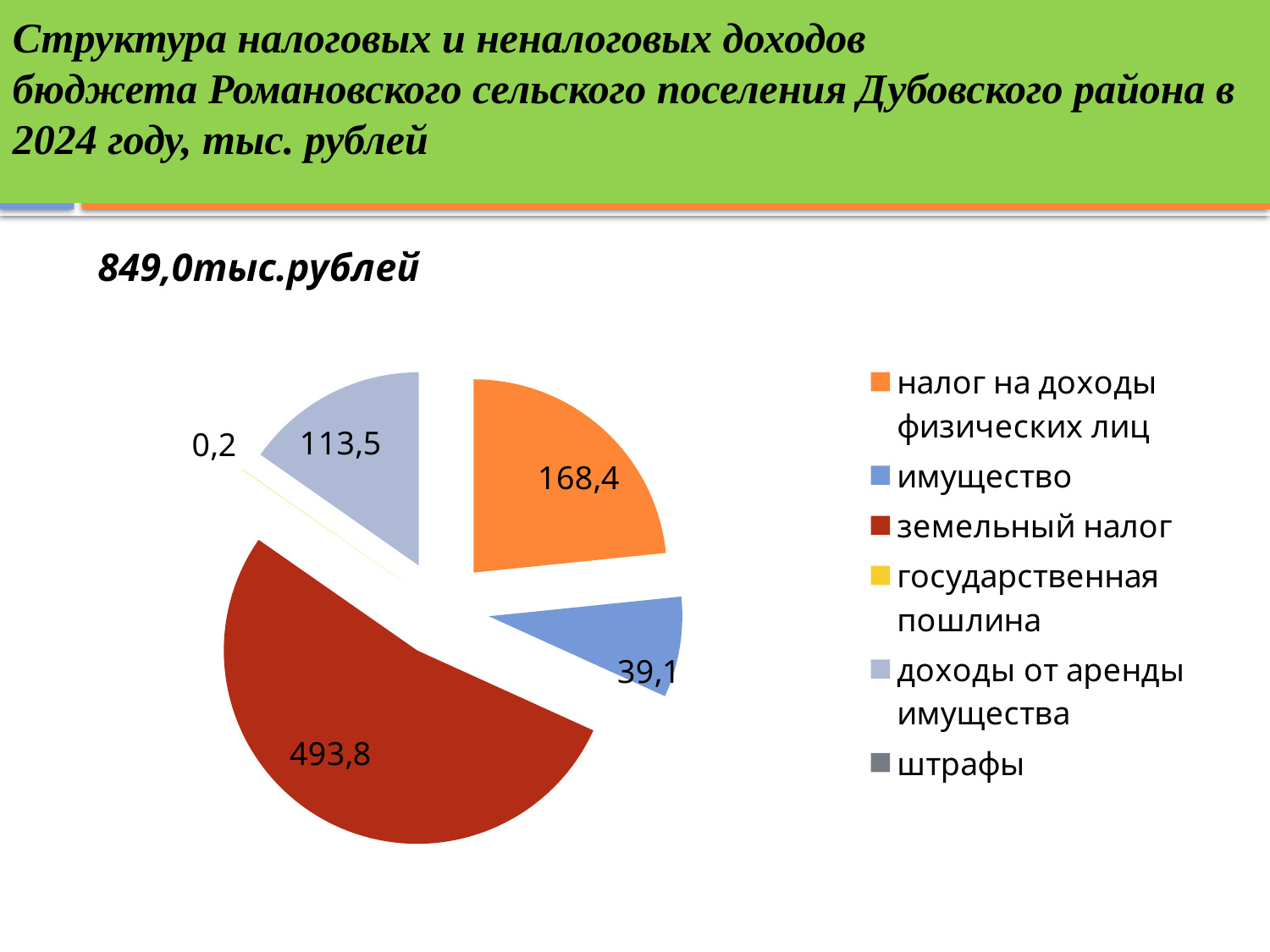
What kind of chart is shown on the slide? pie chart Which category has the largest slice in the pie chart? земельный налог What is the value for имущество? 39,1 What is the difference between the values for земельный налог and налог на доходы физических лиц? 325,4 What is the value for земельный налог in the pie chart? 493,8 What is the value for государственная пошлина? 0,2 How many entries does the legend of the pie chart list? 6 What total amount is printed above the pie chart? 849,0тыс.рублей What is the value for налог на доходы физических лиц? 168,4 What is the difference between the values for налог на доходы физических лиц and доходы от аренды имущества? 54,9 What is the value for доходы от аренды имущества? 113,5 Which is larger, the value for имущество or the value for доходы от аренды имущества? доходы от аренды имущества